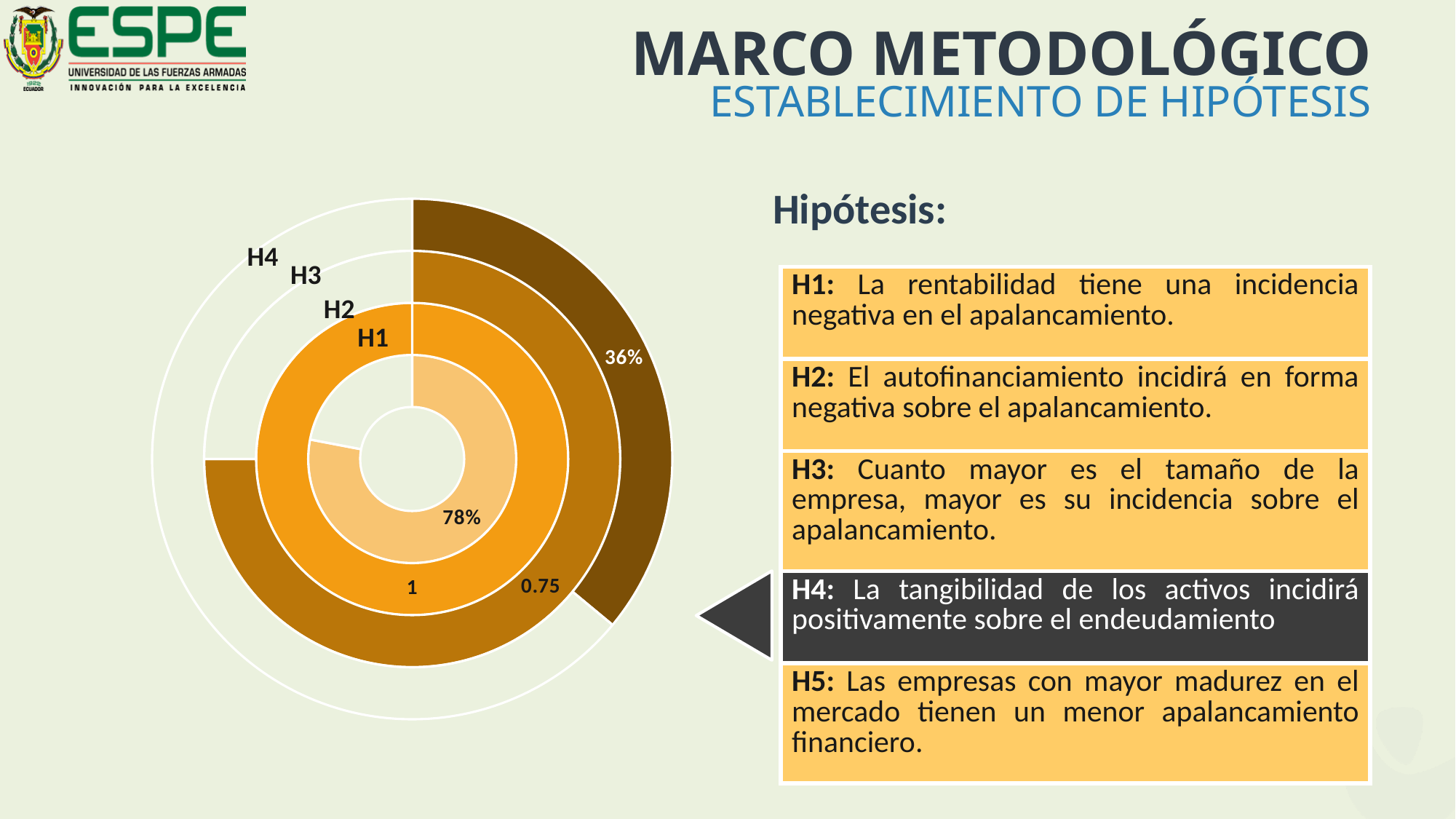
Which ring of the doughnut chart forms a complete circle? H2 What value is labelled on the innermost ring (H1) of the doughnut chart? 78% Which ring label is placed outermost on the doughnut chart? H4 Which ring of the doughnut chart is labelled 36%? H4 What value is labelled on the H2 ring of the doughnut chart? 1 What value is labelled on the H3 ring of the doughnut chart? 0.75 How many rings (categories) does the doughnut chart have? 4 What value is labelled on the outermost ring (H4) of the doughnut chart? 36% What kind of chart is shown on the left of the slide? doughnut chart Which ring of the doughnut chart is labelled 78%? H1